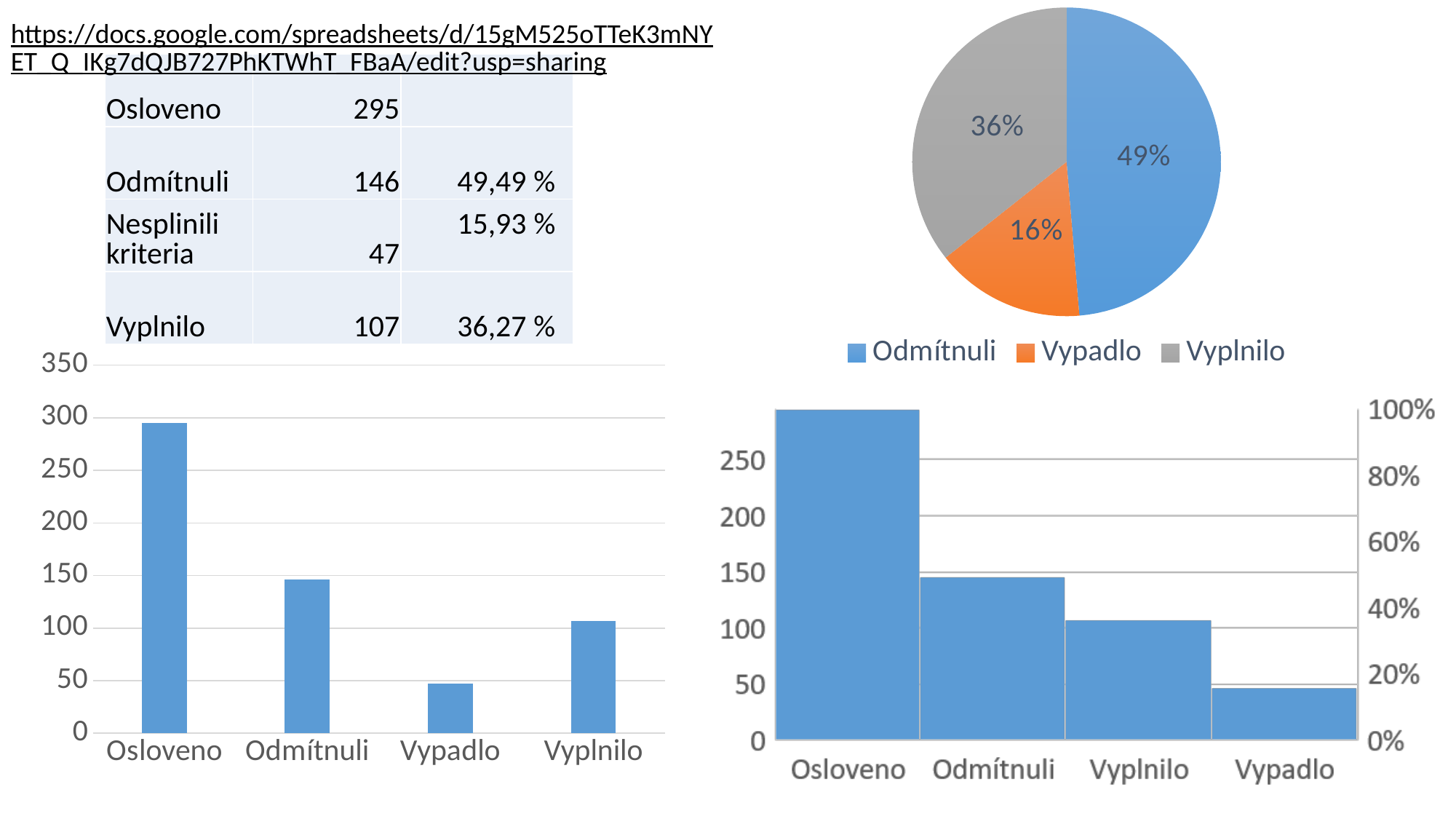
In the pie chart at the top right, what share does Vyplnilo have? 36% In the pie chart at the top right, how many entries does the legend list? 3 In the bar chart at the bottom left, how many categories are shown on the x axis? 4 In the pie chart at the top right, what share does Vypadlo have? 16% In the bar chart at the bottom left, which category has the lowest bar? Vypadlo In the pie chart at the top right, which slice is the smallest? Vypadlo In the pie chart at the top right, which slice is the largest? Odmítnuli In the bar chart at the bottom left, is the value for Odmítnuli greater or less than 100? greater In the bar chart at the bottom left, which category has the highest bar? Osloveno In the pie chart at the top right, what colour is the Vypadlo slice? Orange In the pie chart at the top right, what share does Odmítnuli have? 49%